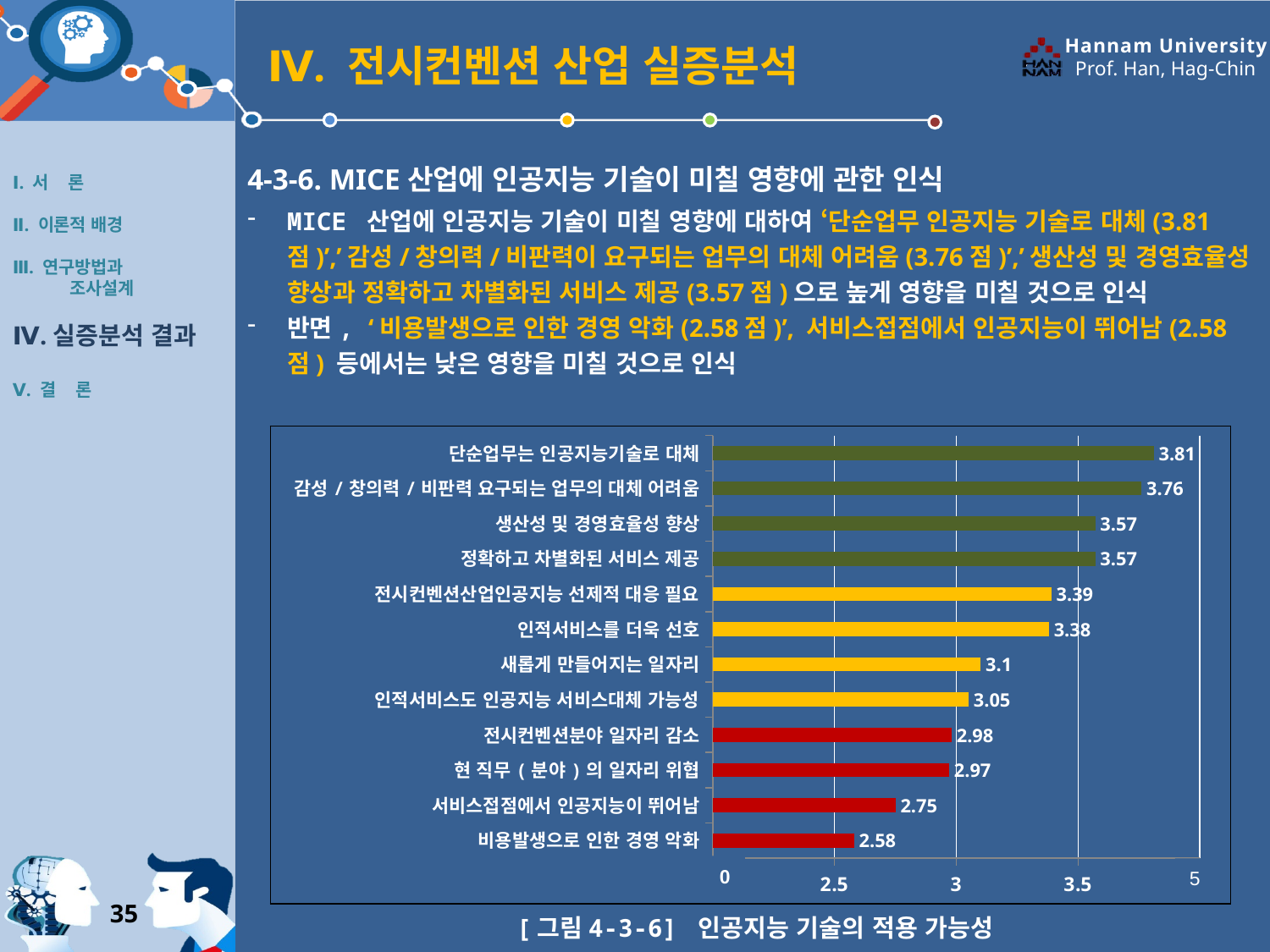
What is the value for 단순업무는 인공지능기술로 대체? 3.81 Which category has the lowest value? 비용발생으로 인한 경영 악화 Which is larger, the value for 인적서비스를 더욱 선호 or the value for 서비스접점에서 인공지능이 뛰어남? 인적서비스를 더욱 선호 What is the value for 비용발생으로 인한 경영 악화? 2.58 Is the value for 전시컨벤션분야 일자리 감소 greater or less than 3? less What is the difference between the values for 단순업무는 인공지능기술로 대체 and 비용발생으로 인한 경영 악화? 1.23 What kind of chart is shown on the slide? bar chart How many categories are shown in the chart? 12 What is the caption of the chart shown below the plot? [그림 4-3-6] 인공지능 기술의 적용 가능성 Which category has the highest value? 단순업무는 인공지능기술로 대체 What is the difference between the values for 감성 / 창의력 / 비판력 요구되는 업무의 대체 어려움 and 생산성 및 경영효율성 향상? 0.19 What is the value for 새롭게 만들어지는 일자리? 3.1